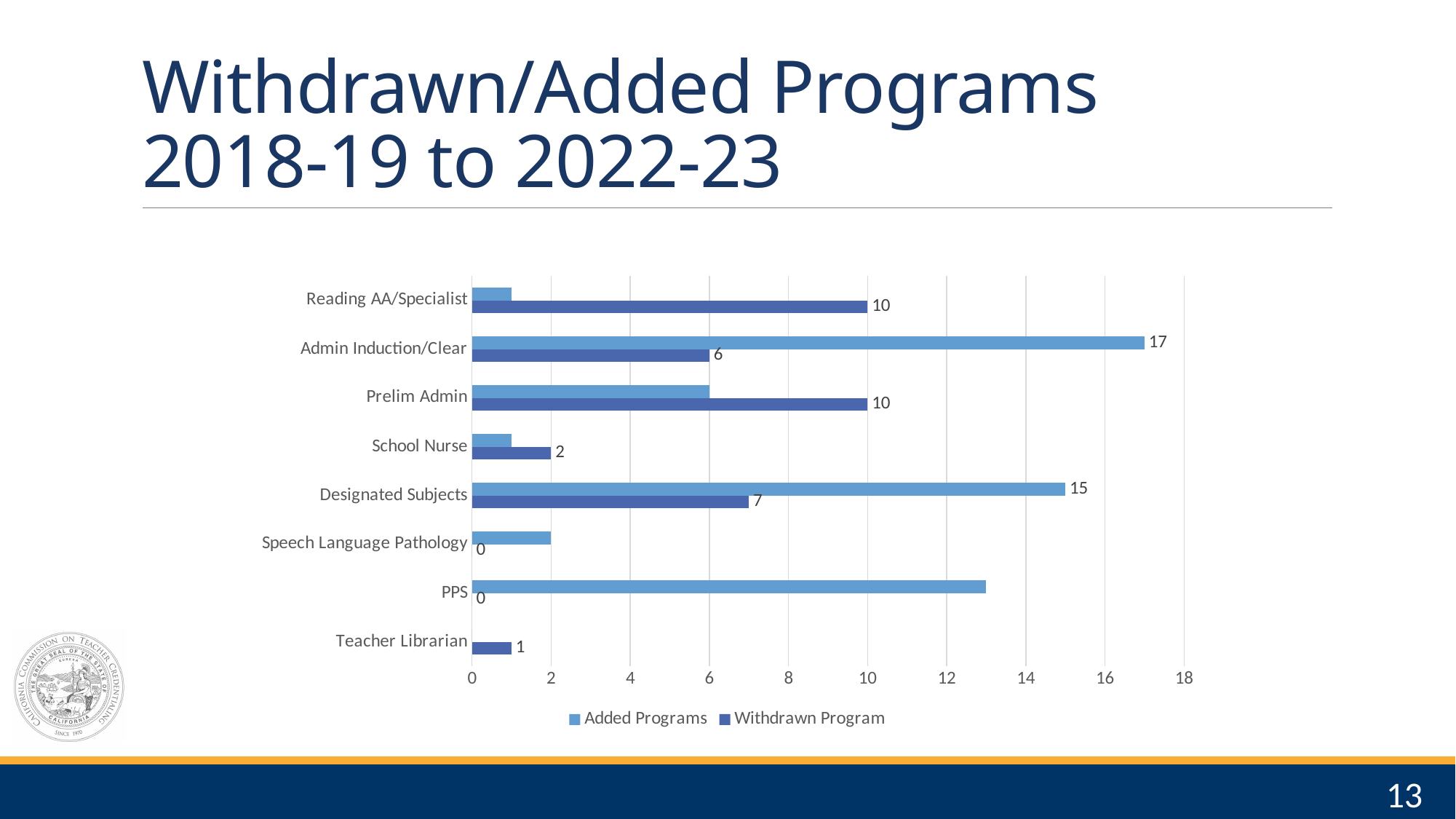
What is the difference between Added Programs and Withdrawn Program for Admin Induction/Clear? 11 What kind of chart is shown on the slide? Bar chart What is the Withdrawn Program value for Designated Subjects? 7 How many program categories are shown on the chart? 8 What is the difference between the Withdrawn Program values for Prelim Admin and School Nurse? 8 How many series does the legend list? 2 For Designated Subjects, which is larger: Added Programs or Withdrawn Program? Added Programs What are the two legend entries on the chart? Added Programs and Withdrawn Program Which category has the highest Added Programs value? Admin Induction/Clear What is the Withdrawn Program value for Reading AA/Specialist? 10 What is the Added Programs value for Admin Induction/Clear? 17 Is the Added Programs value for PPS greater or less than 12? greater